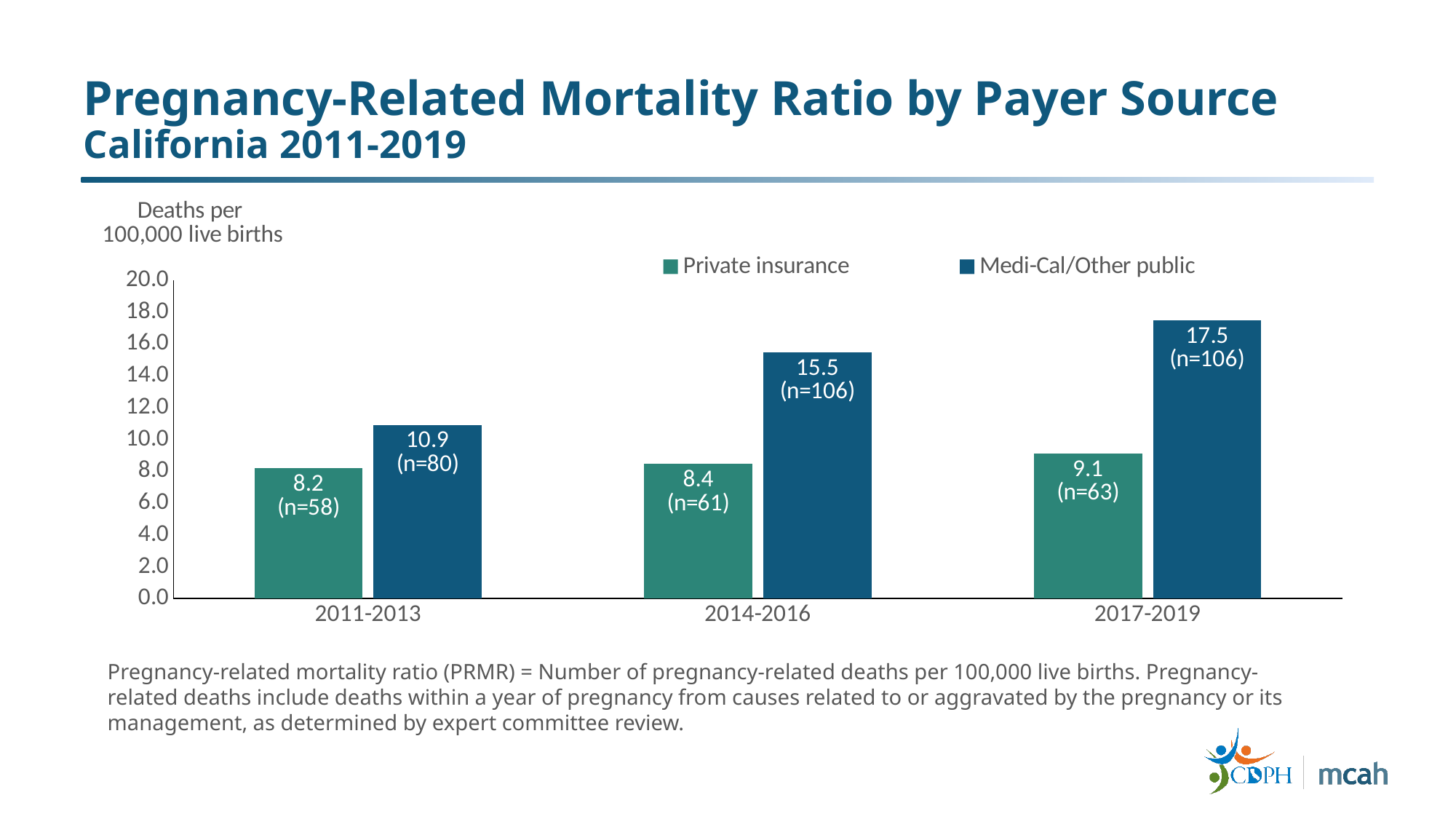
How many deaths (n) are reported for Private insurance in 2017-2019? n=63 Which period has the highest Medi-Cal/Other public mortality ratio? 2017-2019 Does the Medi-Cal/Other public mortality ratio rise or fall across the periods from 2011-2013 to 2017-2019? Rise What is the pregnancy-related mortality ratio for Medi-Cal/Other public in 2014-2016? 15.5 Which period has the lowest Private insurance mortality ratio? 2011-2013 In 2014-2016, which payer source has the higher mortality ratio? Medi-Cal/Other public What is the pregnancy-related mortality ratio for Private insurance in 2011-2013? 8.2 How many time periods are shown on the x axis? 3 What is the pregnancy-related mortality ratio for Medi-Cal/Other public in 2017-2019? 17.5 What is the difference between the Medi-Cal/Other public and Private insurance mortality ratios in 2017-2019? 8.4 What kind of chart is shown on the slide? Bar chart How many series does the legend list? 2